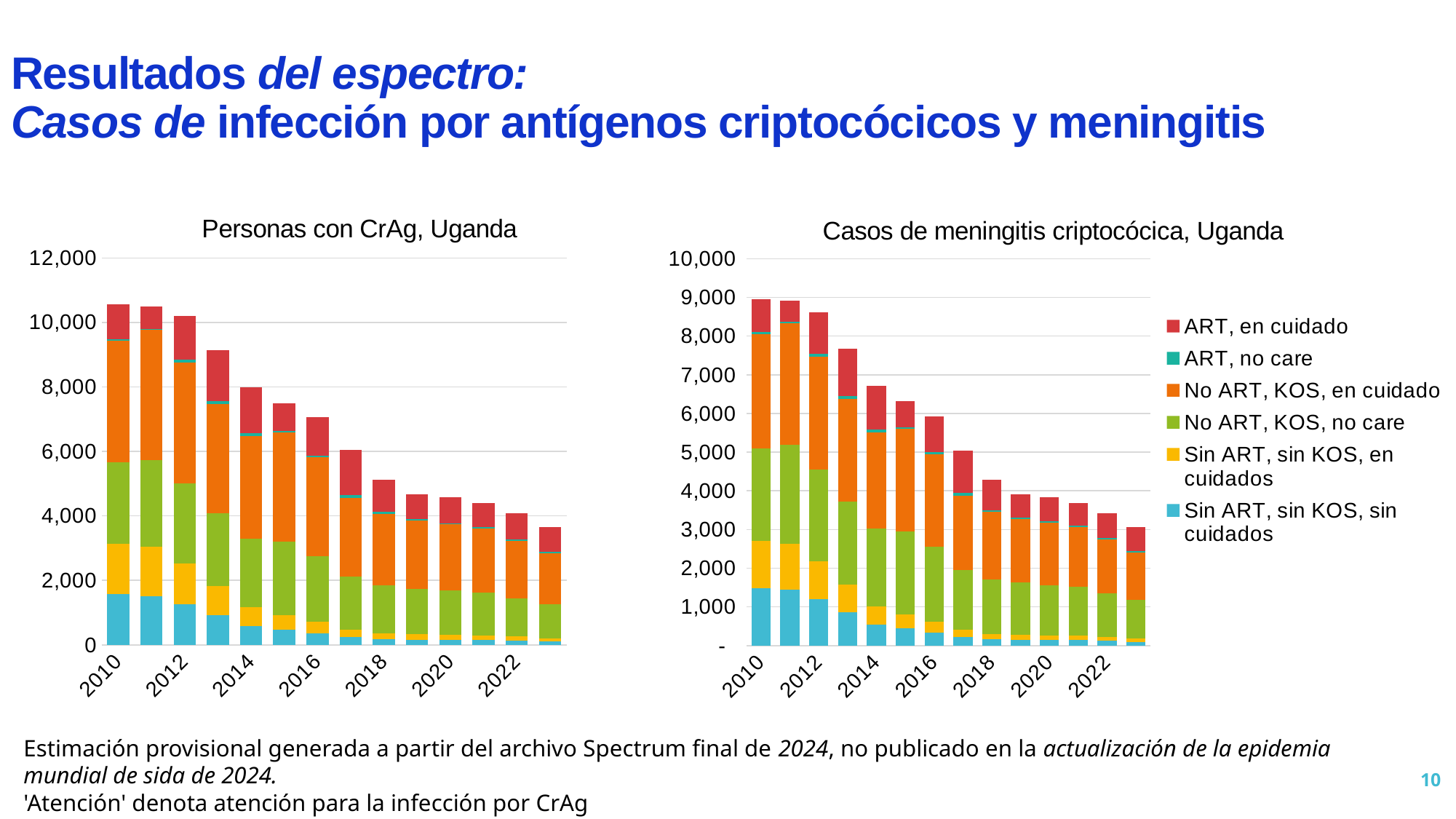
In the 'Personas con CrAg, Uganda' chart, is the total for 2022 greater or less than 6,000? less In the 'Personas con CrAg, Uganda' chart, which year has the larger total, 2010 or 2022? 2010 In the 'Personas con CrAg, Uganda' chart, do the bar totals rise or fall from 2010 to the last year? Fall What kind of chart is 'Personas con CrAg, Uganda'? Stacked bar chart In the 'Casos de meningitis criptocócica, Uganda' chart, how many bars are plotted? 14 What is the title of the chart on the right of the slide? Casos de meningitis criptocócica, Uganda In the 'Casos de meningitis criptocócica, Uganda' chart, is the total for 2020 greater or less than 5,000? less In the 'Casos de meningitis criptocócica, Uganda' chart, which year has the larger total, 2012 or 2018? 2012 In the 'Casos de meningitis criptocócica, Uganda' chart, is the total for 2010 greater or less than 8,000? greater Which colour represents 'ART, en cuidado' in the legend? Red How many series does the legend list? 6